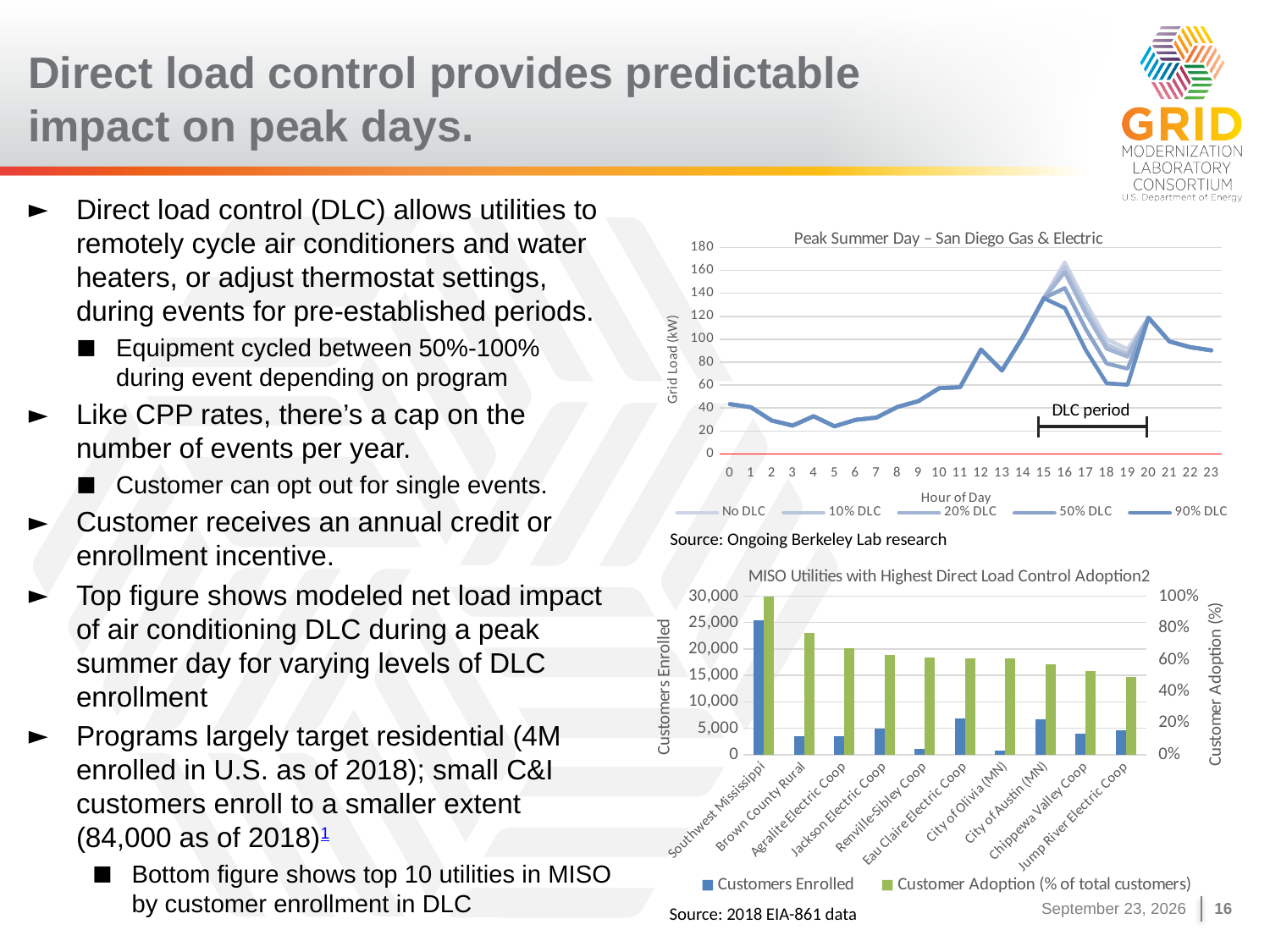
In the bottom chart 'MISO Utilities with Highest Direct Load Control Adoption', which has more customers enrolled: City of Austin (MN) or City of Olivia (MN)? City of Austin (MN) In the bottom chart 'MISO Utilities with Highest Direct Load Control Adoption', what is the label of the right-hand vertical axis? Customer Adoption (%) In the bottom chart 'MISO Utilities with Highest Direct Load Control Adoption', which utility has the highest number of customers enrolled? Southwest Mississippi In the top chart 'Peak Summer Day – San Diego Gas & Electric', how many series does the legend list? 5 In the top chart 'Peak Summer Day – San Diego Gas & Electric', at which hour of day does the No DLC grid load reach its highest value? 16 What type of chart is the bottom chart titled 'MISO Utilities with Highest Direct Load Control Adoption'? bar chart What type of chart is the top chart titled 'Peak Summer Day – San Diego Gas & Electric'? line chart In the bottom chart 'MISO Utilities with Highest Direct Load Control Adoption', is the customer adoption for Brown County Rural greater or less than 60%? greater In the bottom chart 'MISO Utilities with Highest Direct Load Control Adoption', how many utilities are shown on the x axis? 10 In the top chart 'Peak Summer Day – San Diego Gas & Electric', is the No DLC grid load at hour 16 greater or less than 140 kW? greater In the top chart 'Peak Summer Day – San Diego Gas & Electric', is the grid load at hour 0 greater or less than 60 kW? less